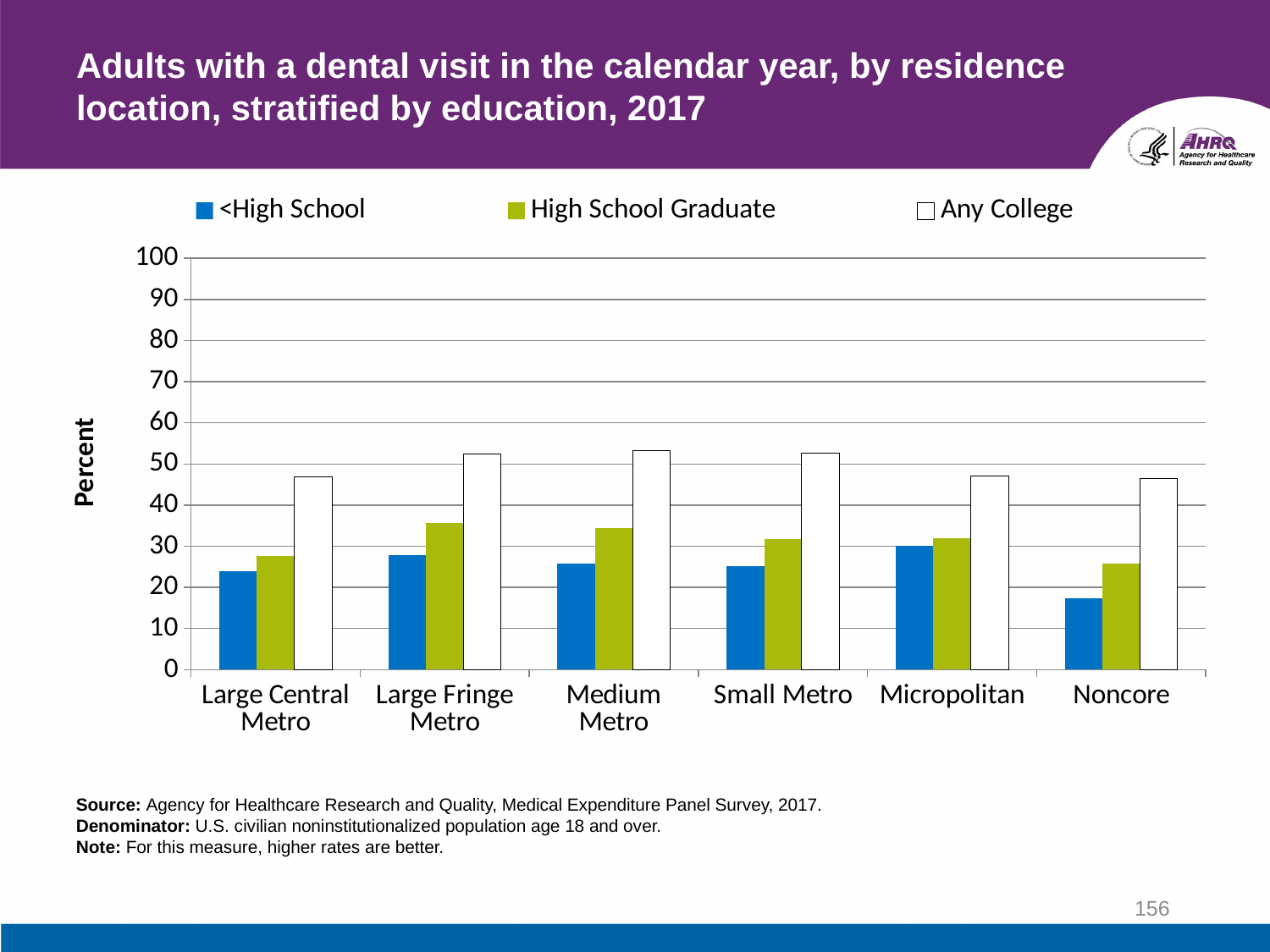
Is the High School Graduate value for Large Fringe Metro greater or less than 30? greater Is the Any College value for Medium Metro greater or less than 50? greater Which is larger: the High School Graduate value for Large Fringe Metro or for Noncore? Large Fringe Metro Is the Any College value for Large Central Metro greater or less than 50? less Which residence location has the lowest value for <High School? Noncore How many residence location categories are shown on the x axis? 6 For Small Metro, which is larger: the Any College value or the <High School value? Any College What kind of chart is shown on the slide? bar chart What is the label on the vertical axis? Percent How many series does the legend list? 3